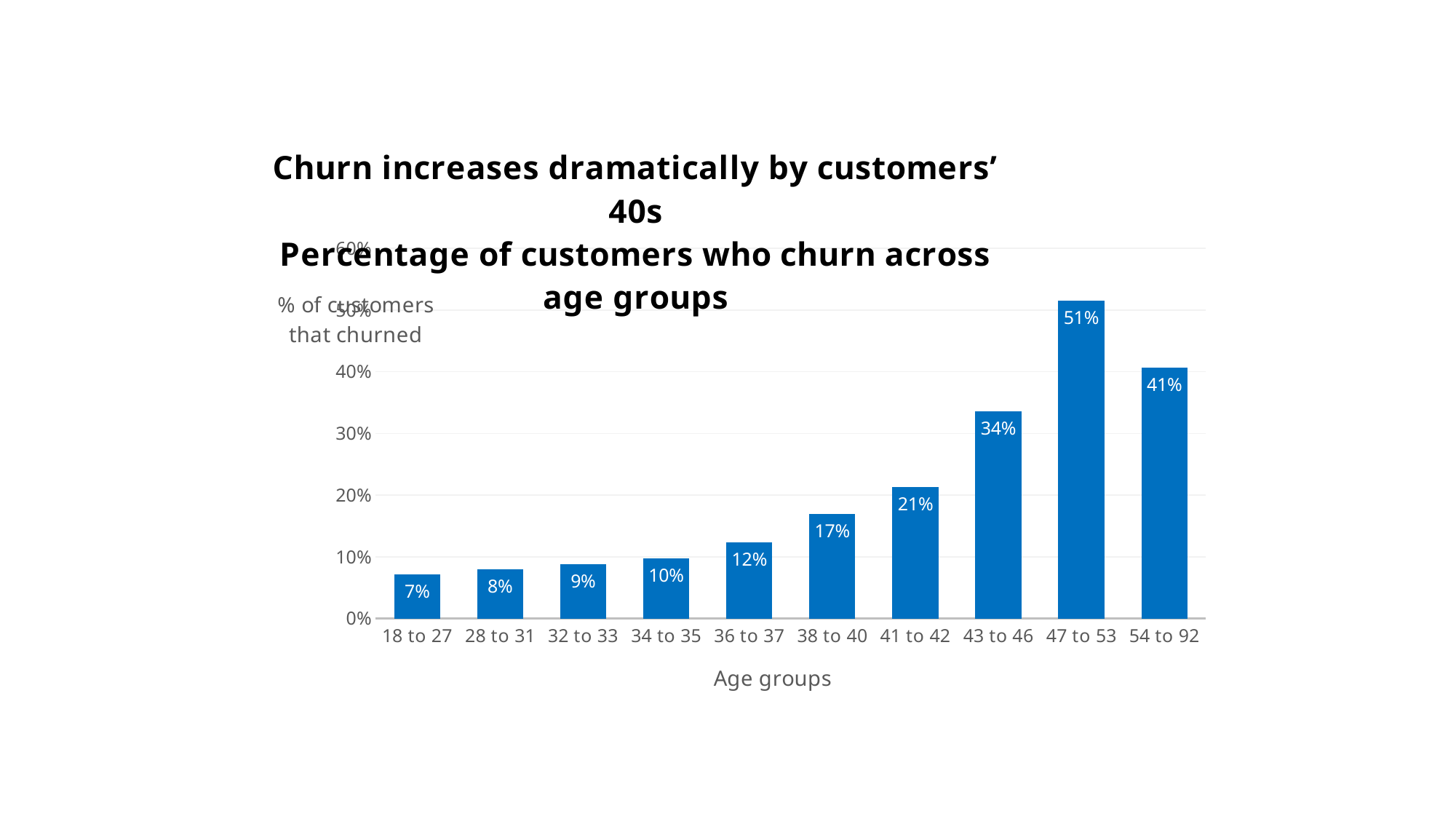
What is the churn percentage for the 47 to 53 age group? 51% What kind of chart is shown on the slide? Bar chart What is the label of the x axis? Age groups What is the churn percentage for the 38 to 40 age group? 17% What is the difference in churn percentage between the 47 to 53 and 54 to 92 age groups? 10% Do churn percentages generally rise or fall from the youngest to the oldest age groups? Rise What is the churn percentage for the 18 to 27 age group? 7% Which age group has the highest churn percentage? 47 to 53 Which age group has a higher churn percentage, 43 to 46 or 41 to 42? 43 to 46 Is the value for the 54 to 92 age group greater or less than 40%? greater Which age group has the lowest churn percentage? 18 to 27 How many age groups are shown on the x axis? 10